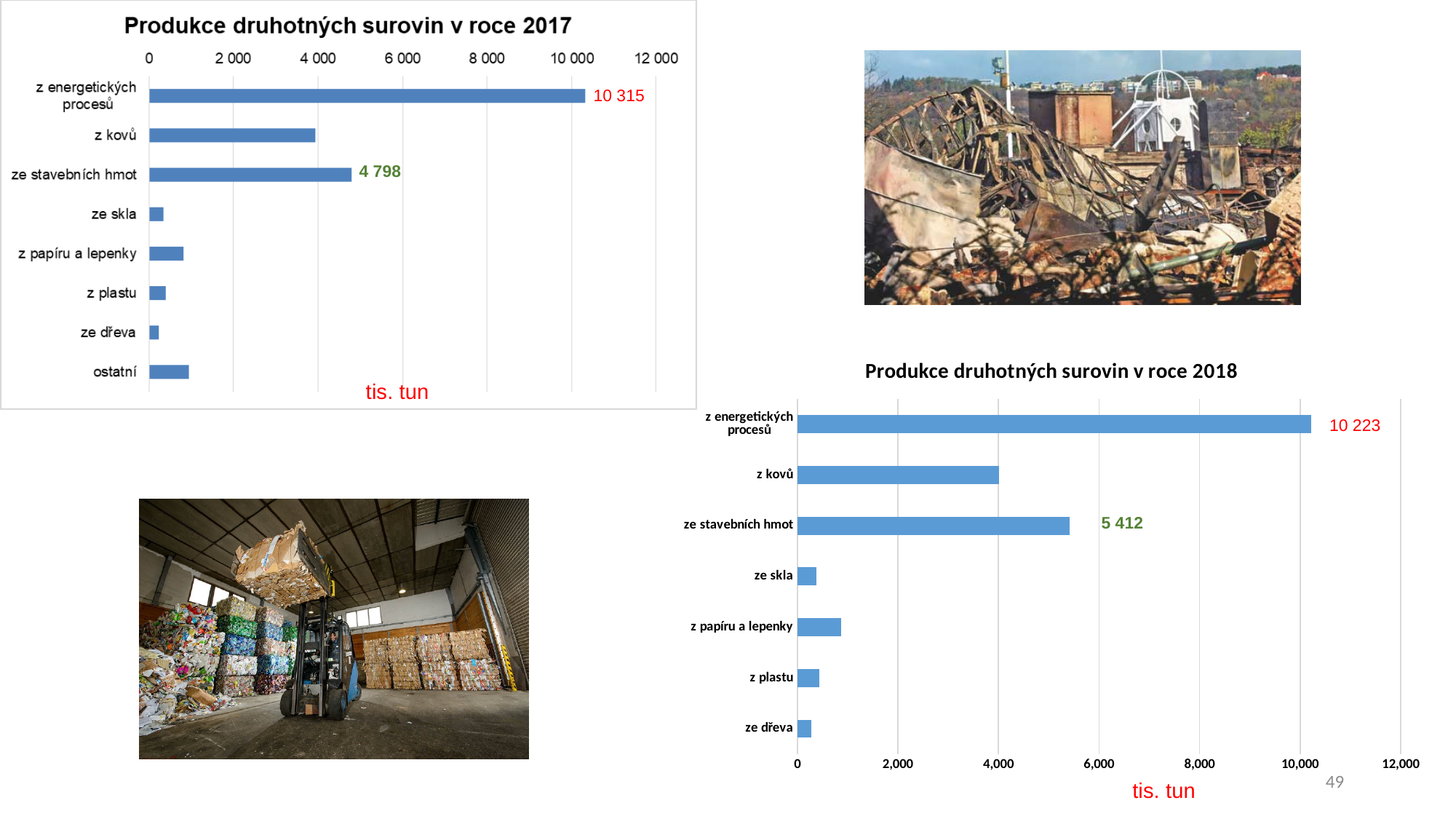
In the chart 'Produkce druhotných surovin v roce 2018', what is the difference between 'z energetických procesů' and 'ze stavebních hmot'? 4 811 How many categories are shown in the chart 'Produkce druhotných surovin v roce 2017'? 8 What type of chart is 'Produkce druhotných surovin v roce 2018'? bar chart In the chart 'Produkce druhotných surovin v roce 2017', which category has the lowest value? ze dřeva In the chart 'Produkce druhotných surovin v roce 2018', what is the value for 'ze stavebních hmot'? 5 412 In the chart 'Produkce druhotných surovin v roce 2017', what is the value for 'ze stavebních hmot'? 4 798 In the chart 'Produkce druhotných surovin v roce 2017', which category has the highest value? z energetických procesů In the chart 'Produkce druhotných surovin v roce 2017', what is the value for 'z energetických procesů'? 10 315 Comparing the two charts, is the value for 'ze stavebních hmot' larger in 2017 or in 2018? 2018 How many categories are shown in the chart 'Produkce druhotných surovin v roce 2018'? 7 In the chart 'Produkce druhotných surovin v roce 2018', what is the value for 'z energetických procesů'? 10 223 In the chart 'Produkce druhotných surovin v roce 2018', is the value for 'z kovů' greater or less than 2,000? greater